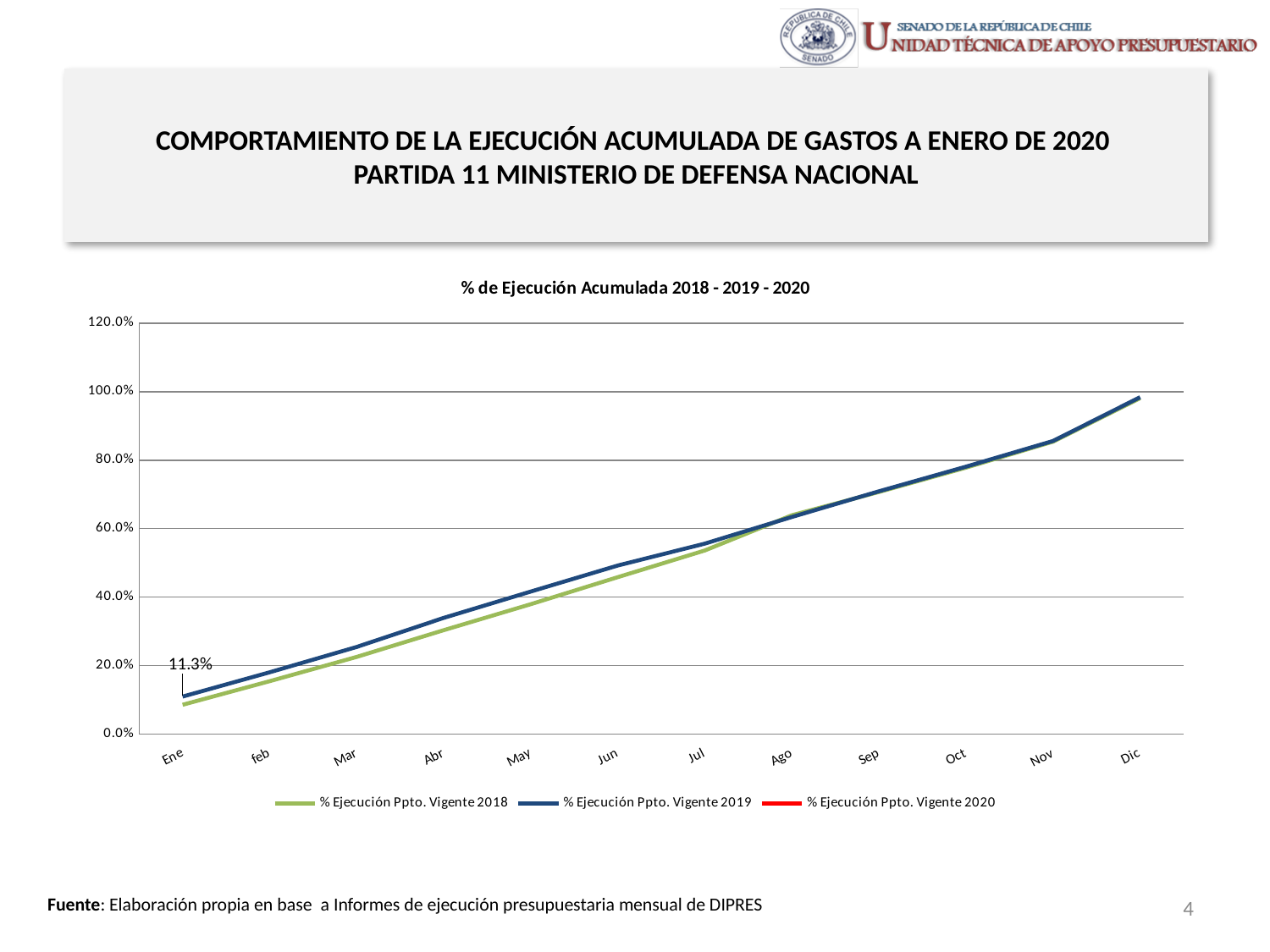
Do the values for % Ejecución Ppto. Vigente 2019 rise or fall from Ene to Dic? rise What value is printed as a data label at Ene? 11.3% Is the value for % Ejecución Ppto. Vigente 2018 in Ene greater or less than 20.0%? less How many series does the legend list? 3 What kind of chart is shown on the slide? line chart How many months are shown on the x axis? 12 Is the value for % Ejecución Ppto. Vigente 2019 in Jun greater or less than 40.0%? greater Is the value for % Ejecución Ppto. Vigente 2019 in Dic greater or less than 80.0%? greater In which month does % Ejecución Ppto. Vigente 2019 reach its highest value? Dic In which month is % Ejecución Ppto. Vigente 2018 at its lowest value? Ene In Mar, which series is higher: % Ejecución Ppto. Vigente 2018 or % Ejecución Ppto. Vigente 2019? % Ejecución Ppto. Vigente 2019 What is the title of the chart? % de Ejecución Acumulada 2018 - 2019 - 2020